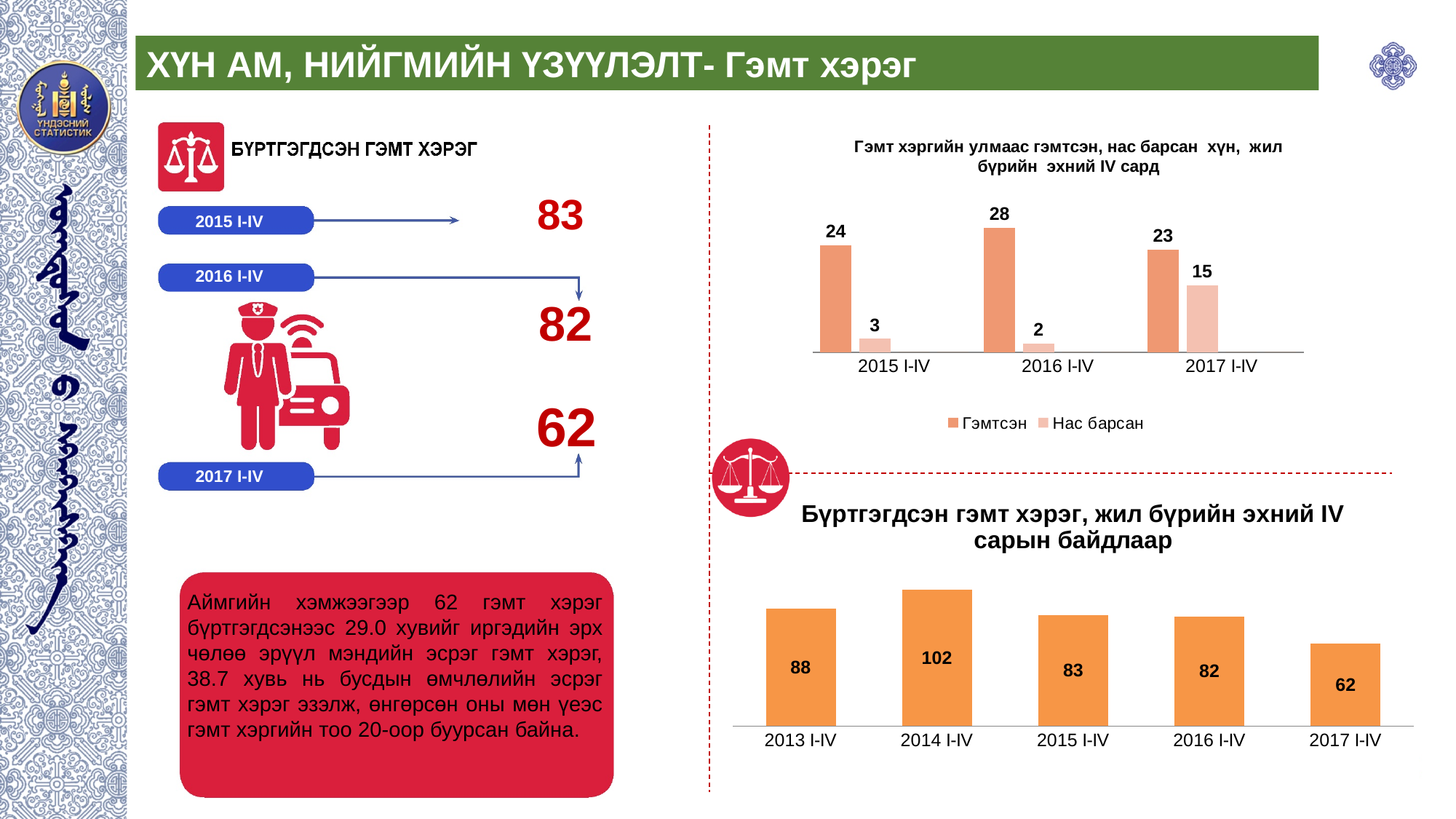
How many periods are shown on the x axis of the bottom-right chart 'Бүртгэгдсэн гэмт хэрэг'? 5 In the bottom-right chart 'Бүртгэгдсэн гэмт хэрэг', which period has the lowest value? 2017 I-IV In the top-right chart 'Гэмт хэргийн улмаас гэмтсэн, нас барсан хүн', what is the difference between Гэмтсэн and Нас барсан in 2017 I-IV? 8 In the bottom-right chart 'Бүртгэгдсэн гэмт хэрэг', what is the difference between 2014 I-IV and 2017 I-IV? 40 How many series does the legend of the top-right chart 'Гэмт хэргийн улмаас гэмтсэн, нас барсан хүн' list? 2 In the top-right chart 'Гэмт хэргийн улмаас гэмтсэн, нас барсан хүн', which period has the highest Гэмтсэн value? 2016 I-IV In the top-right chart 'Гэмт хэргийн улмаас гэмтсэн, нас барсан хүн', which period has the lowest Нас барсан value? 2016 I-IV In the top-right chart 'Гэмт хэргийн улмаас гэмтсэн, нас барсан хүн', what is the value for Нас барсан in 2017 I-IV? 15 In the bottom-right chart 'Бүртгэгдсэн гэмт хэрэг', which is larger, the value for 2013 I-IV or 2015 I-IV? 2013 I-IV In the top-right chart 'Гэмт хэргийн улмаас гэмтсэн, нас барсан хүн', what is the value for Гэмтсэн in 2016 I-IV? 28 What kind of chart is the bottom-right chart 'Бүртгэгдсэн гэмт хэрэг'? Bar chart In the bottom-right chart 'Бүртгэгдсэн гэмт хэрэг', what is the value for 2014 I-IV? 102